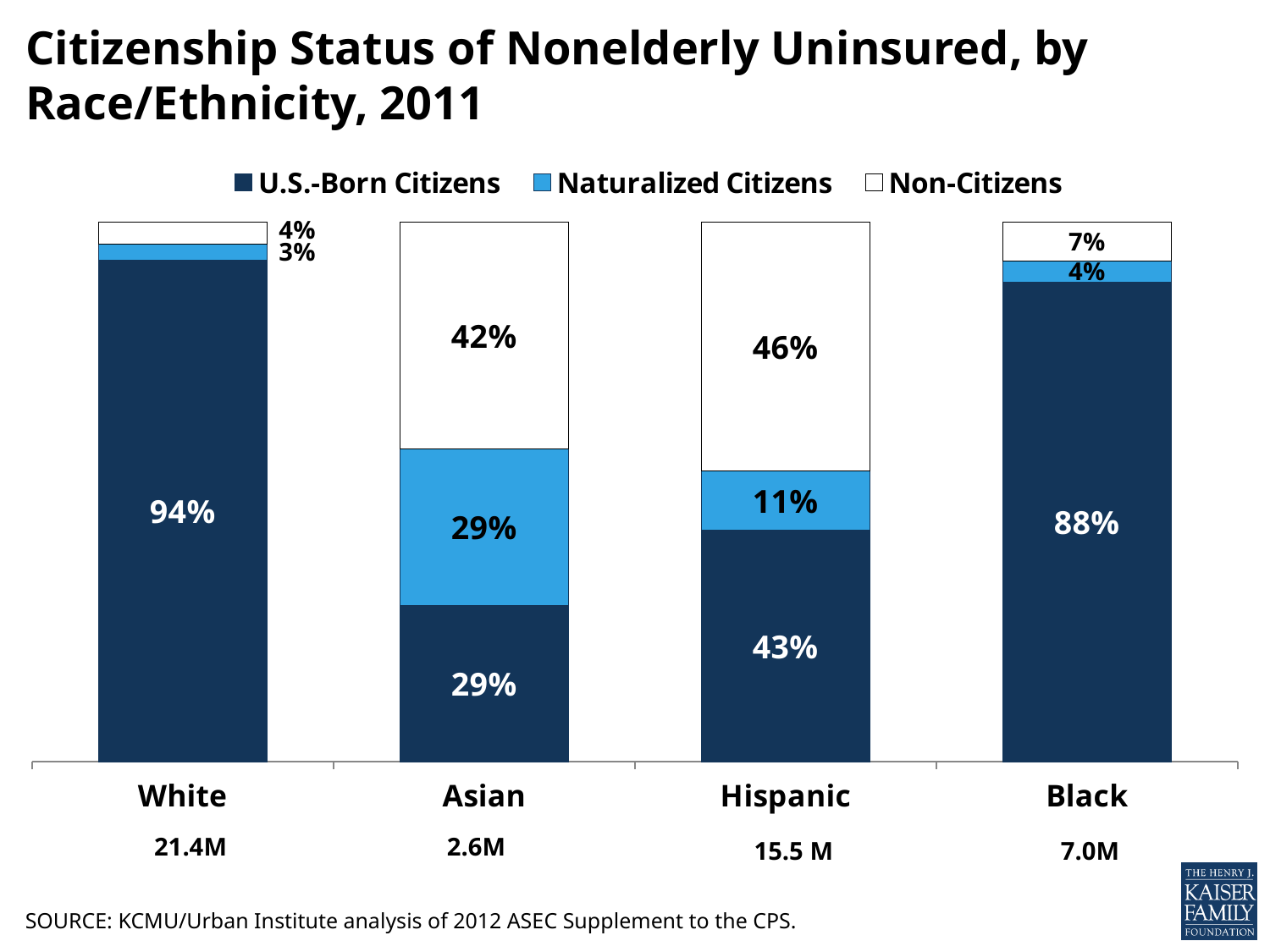
Which race/ethnicity group has the lowest share of U.S.-Born Citizens among the nonelderly uninsured? Asian How many series does the legend list? 3 What percentage of nonelderly uninsured White people are U.S.-Born Citizens? 94% What is the total number of nonelderly uninsured shown below the White bar? 21.4M What is the difference in percentage points between the Non-Citizen share for Hispanic and for Asian nonelderly uninsured? 4 percentage points What percentage of nonelderly uninsured Hispanic people are Non-Citizens? 46% What percentage of nonelderly uninsured Black people are Non-Citizens? 7% How many race/ethnicity categories are shown on the x axis? 4 What kind of chart is shown on the slide? Stacked bar chart What percentage of nonelderly uninsured Asian people are Naturalized Citizens? 29% Which group has a larger Naturalized Citizens share among the nonelderly uninsured, Hispanic or Black? Hispanic Which race/ethnicity group has the highest share of U.S.-Born Citizens among the nonelderly uninsured? White